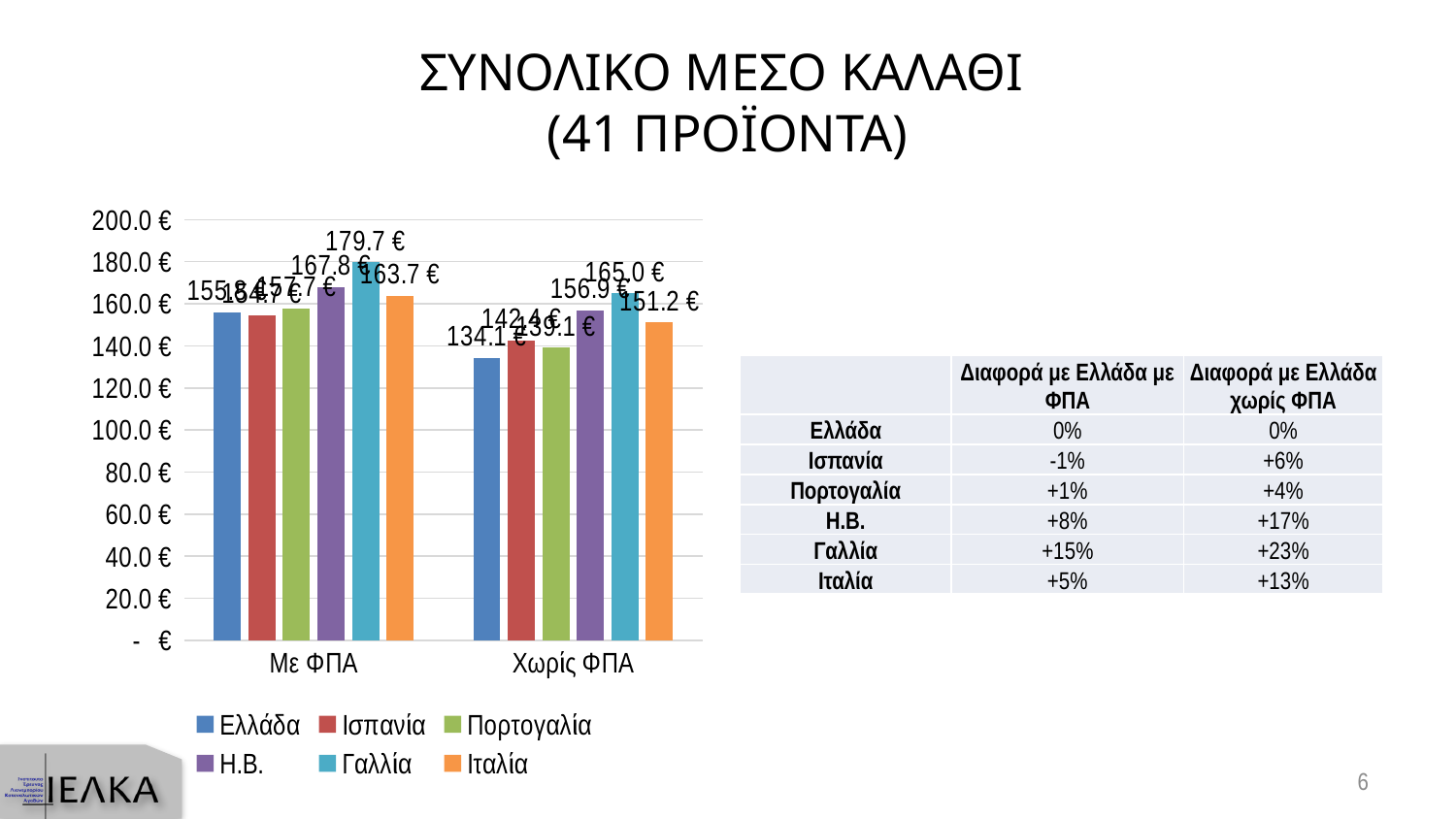
Which country has the lowest value in the Χωρίς ΦΠΑ category? Ελλάδα What is the value for Ελλάδα in the Χωρίς ΦΠΑ category? 134.1 € What is the value for Η.Β. in the Χωρίς ΦΠΑ category? 156.9 € Which country has the highest value in the Με ΦΠΑ category? Γαλλία What is the value for Γαλλία in the Χωρίς ΦΠΑ category? 165.0 € In the Χωρίς ΦΠΑ category, which is larger: the value for Η.Β. or the value for Ιταλία? Η.Β. What kind of chart is shown on the slide? bar chart What is the value for Γαλλία in the Με ΦΠΑ category? 179.7 € How many categories are shown on the x axis of the chart? 2 What is the value for Ιταλία in the Με ΦΠΑ category? 163.7 € What is the difference between the Με ΦΠΑ and Χωρίς ΦΠΑ values for Γαλλία? 14.7 € How many series does the chart legend list? 6